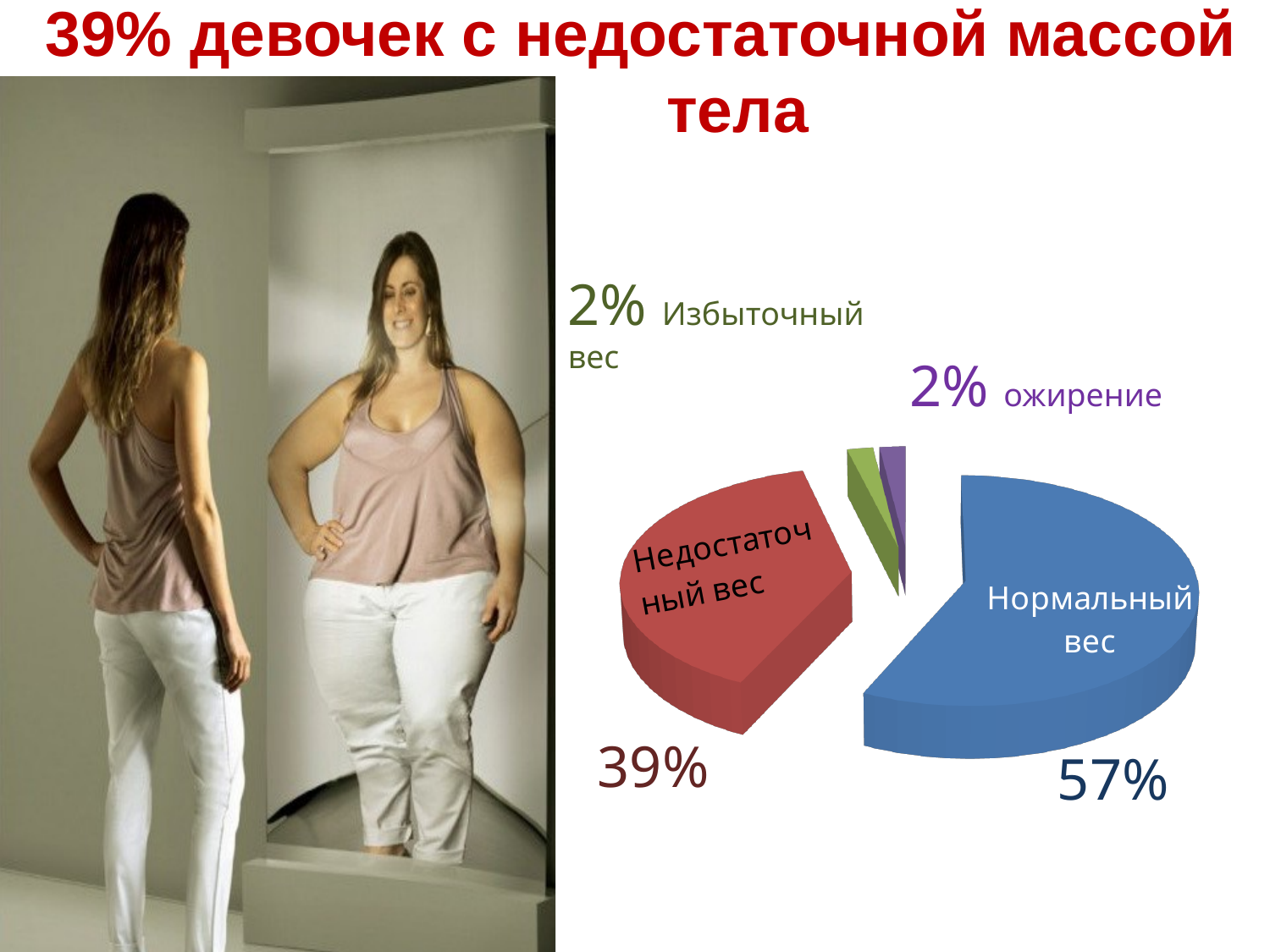
How many slices does the pie chart have? 4 What value is shown for "ожирение"? 2% What colour is the "Недостаточный вес" slice? red What kind of chart is shown on the slide? pie chart What colour is the "Нормальный вес" slice? blue What value is shown for "Избыточный вес"? 2% What share of the pie does the "Нормальный вес" slice represent? 57% Which category has the largest slice of the pie? Нормальный вес What is the combined share of "Избыточный вес" and "ожирение"? 4% What share of the pie does the "Недостаточный вес" slice represent? 39% Which is larger, the share for "Недостаточный вес" or the share for "Нормальный вес"? Нормальный вес What is the difference between the "Нормальный вес" and "Недостаточный вес" shares? 18%